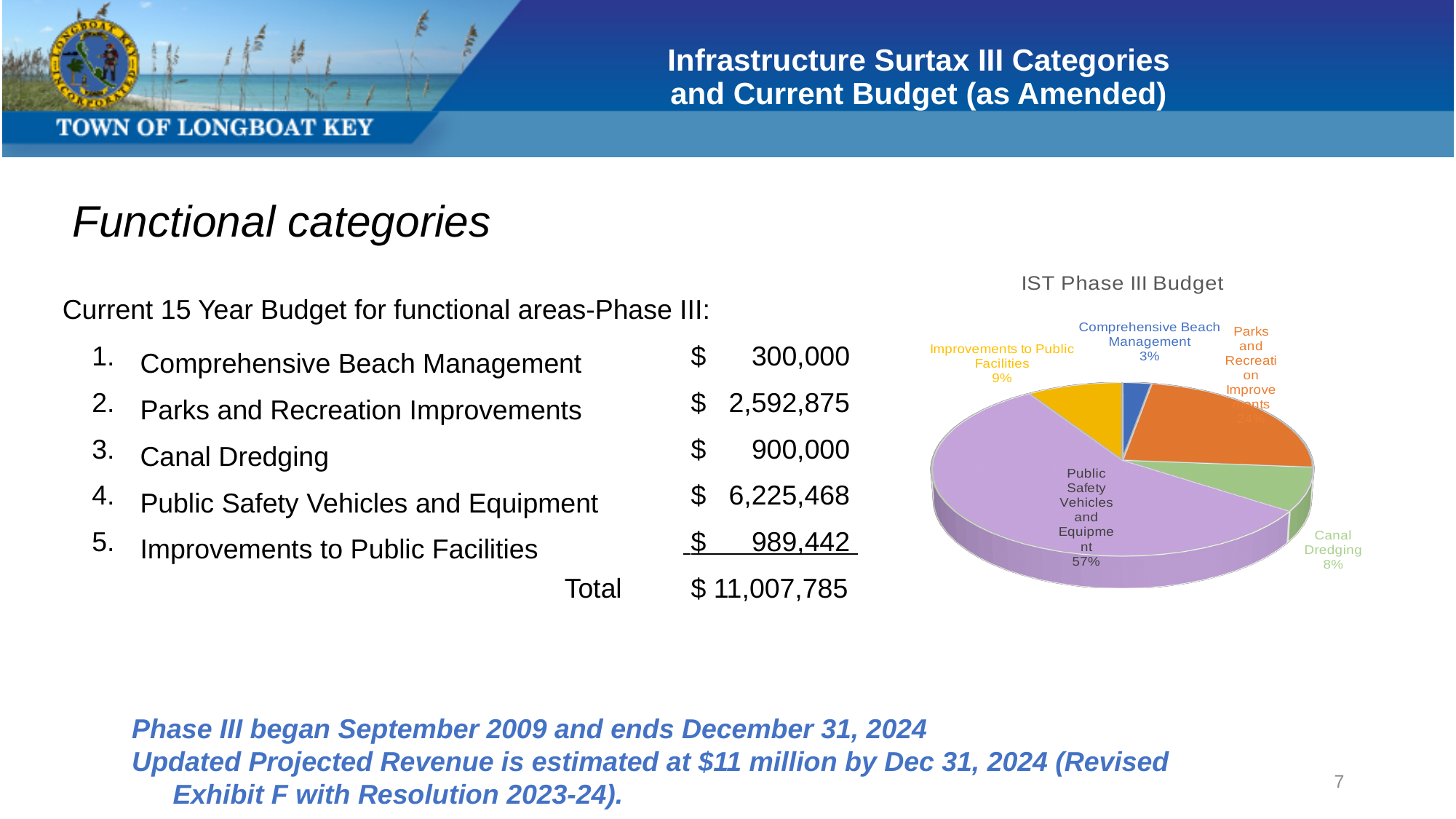
What is the title of the pie chart? IST Phase III Budget How many slices does the IST Phase III Budget pie chart have? 5 What share of the IST Phase III Budget pie is Improvements to Public Facilities? 9% What kind of chart is shown on the slide? pie chart In the IST Phase III Budget pie chart, which is larger: Canal Dredging or Improvements to Public Facilities? Improvements to Public Facilities What colour is the Public Safety Vehicles and Equipment slice in the IST Phase III Budget pie chart? purple In the IST Phase III Budget pie chart, how many percentage points larger is Improvements to Public Facilities than Comprehensive Beach Management? 6% Which category has the largest slice in the IST Phase III Budget pie chart? Public Safety Vehicles and Equipment What share of the IST Phase III Budget pie is Public Safety Vehicles and Equipment? 57% Which category has the smallest slice in the IST Phase III Budget pie chart? Comprehensive Beach Management What share of the IST Phase III Budget pie is Comprehensive Beach Management? 3%